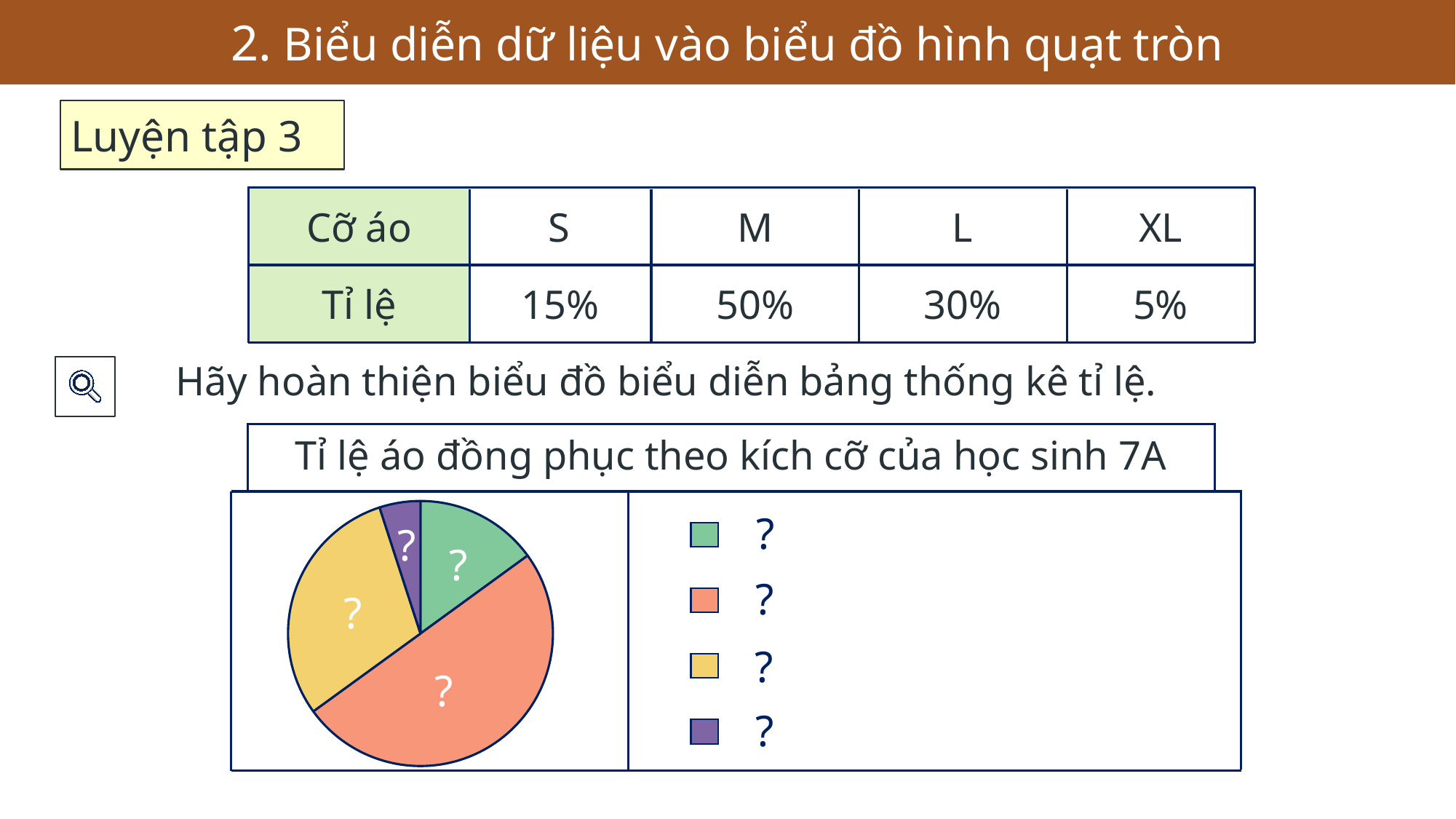
Which colour slice of the pie chart is the smallest? purple What kind of chart is shown on the slide? pie chart How many slices does the pie chart have? 4 Which is larger in the pie chart, the green slice or the purple slice? green Which is larger in the pie chart, the yellow slice or the green slice? yellow Which is larger in the pie chart, the orange slice or the yellow slice? orange Which colour slice of the pie chart is the largest? orange What is the title of the chart? Tỉ lệ áo đồng phục theo kích cỡ của học sinh 7A How many entries does the chart's legend list? 4 What text is shown as the label on each slice of the pie chart? ?